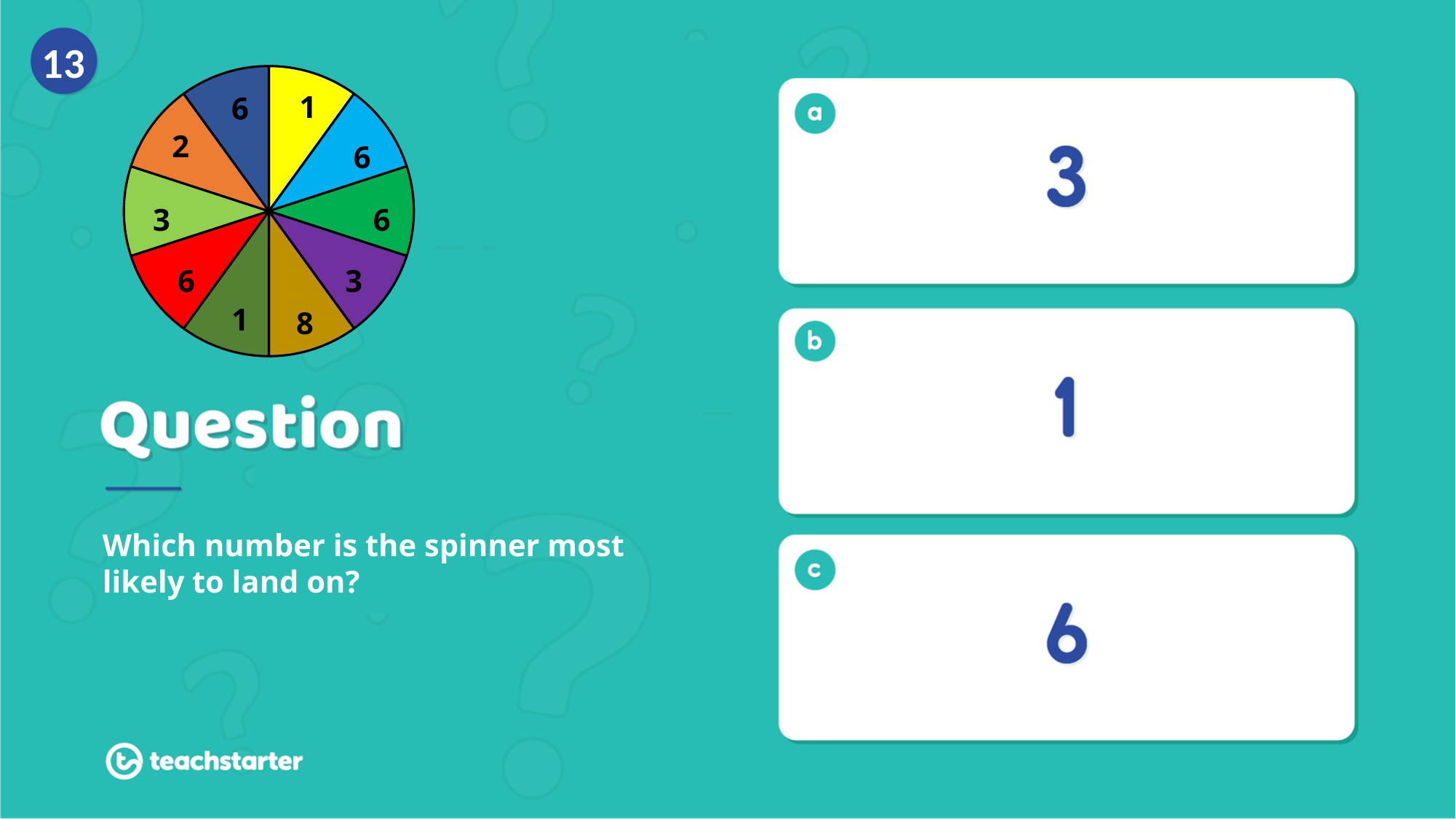
What kind of chart is the spinner drawn as? pie chart How many sectors of the spinner are labelled 1? 2 Which number appears on the most sectors of the spinner? 6 How many sectors of the spinner are labelled 3? 2 What number is on the red sector of the spinner? 6 How many sectors of the spinner are labelled 6? 4 What number is on the yellow sector of the spinner? 1 Which number appears on more sectors of the spinner, 3 or 6? 6